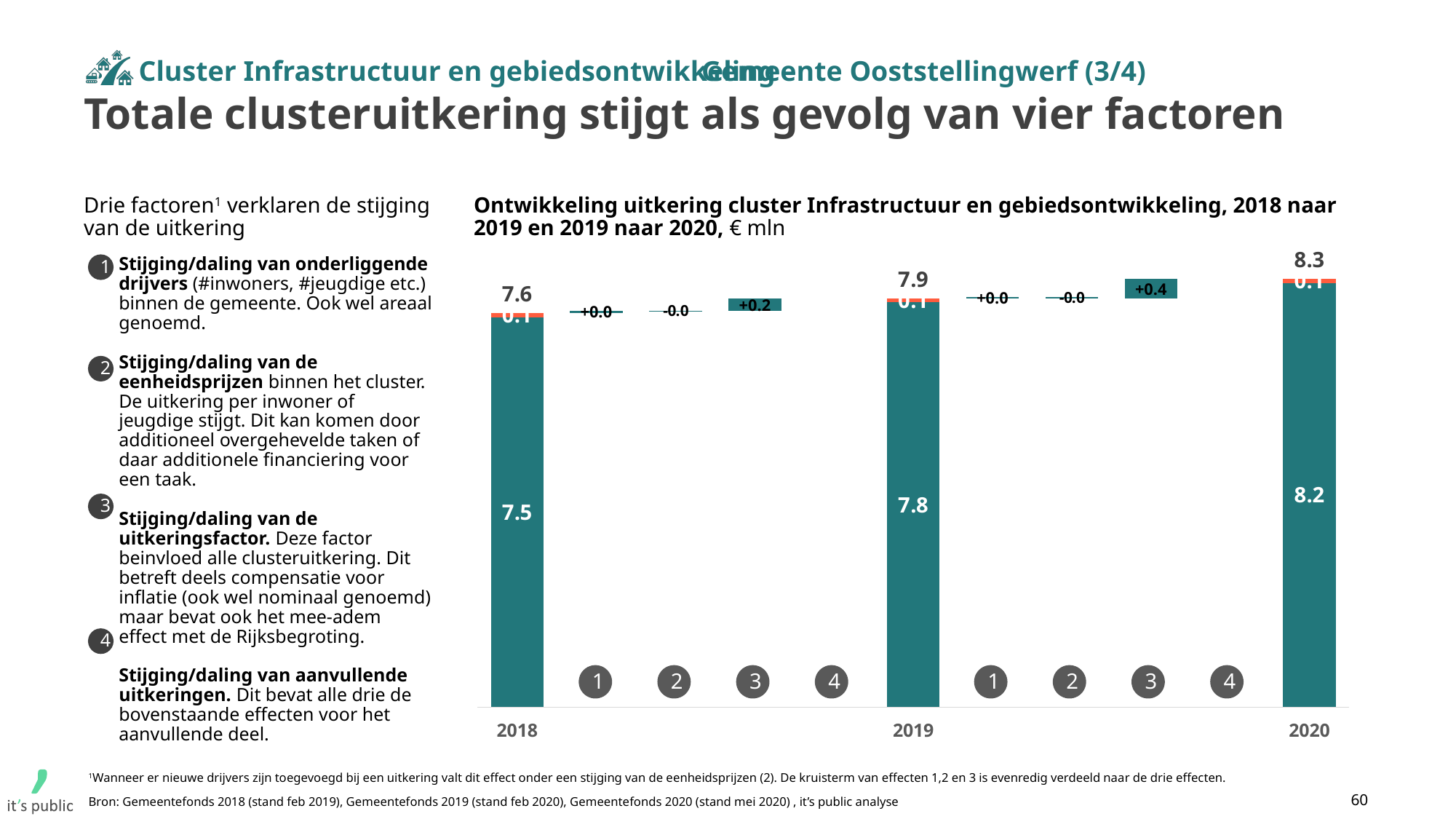
What is the value of the large teal segment of the 2018 bar? 7.5 What is the difference between the 2020 total (8.3) and the 2018 total (7.6)? 0.7 What is the total value shown above the bar for 2020? 8.3 What is the value of factor 3 (uitkeringsfactor) in the step from 2018 to 2019? +0.2 What is the total value shown above the bar for 2019? 7.9 Which year has the lowest total cluster payout? 2018 What is the total value shown above the bar for 2018? 7.6 What is the value of the large teal segment of the 2020 bar? 8.2 Which year has the highest total cluster payout? 2020 What is the value of factor 3 (uitkeringsfactor) in the step from 2019 to 2020? +0.4 Do the yearly totals rise or fall from 2018 to 2020? rise What unit is stated in the chart title? € mln